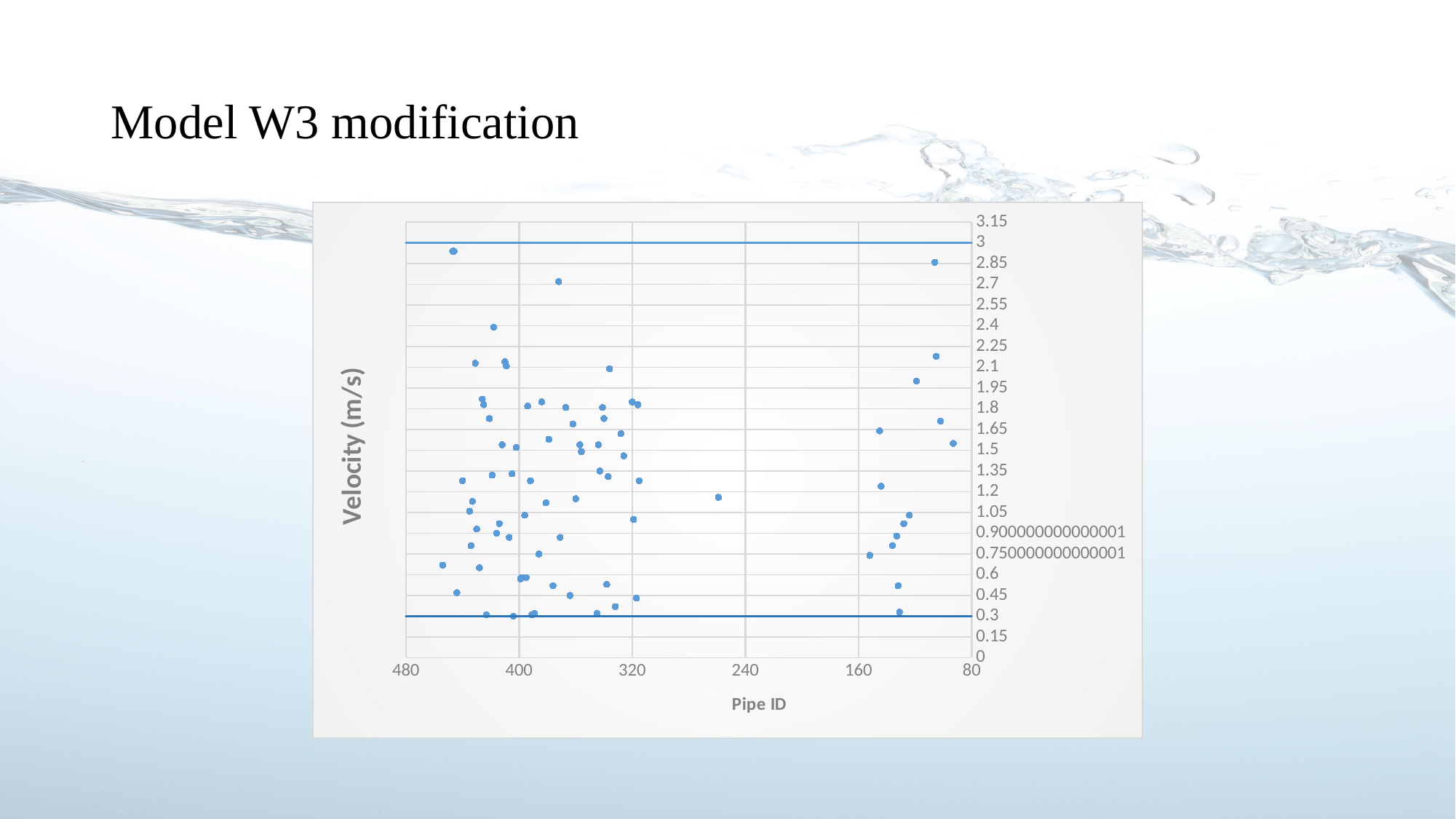
How many tick labels are shown on the horizontal (Pipe ID) axis? 6 What is the title of the horizontal axis of the chart? Pipe ID What is the highest value shown on the vertical axis? 3.15 At what velocity value is the upper horizontal line drawn across the chart? 3 What kind of chart is shown on the slide? scatter chart Is the velocity of the point plotted near Pipe ID 260 greater or less than 1.5? less Is the velocity of the point plotted near Pipe ID 440 at the top left greater or less than 2.7? greater What is the title of the vertical axis of the chart? Velocity (m/s) At what velocity value is the lower horizontal line drawn across the chart? 0.3 Is the velocity of the point plotted near Pipe ID 100 at the top right greater or less than 2.7? greater